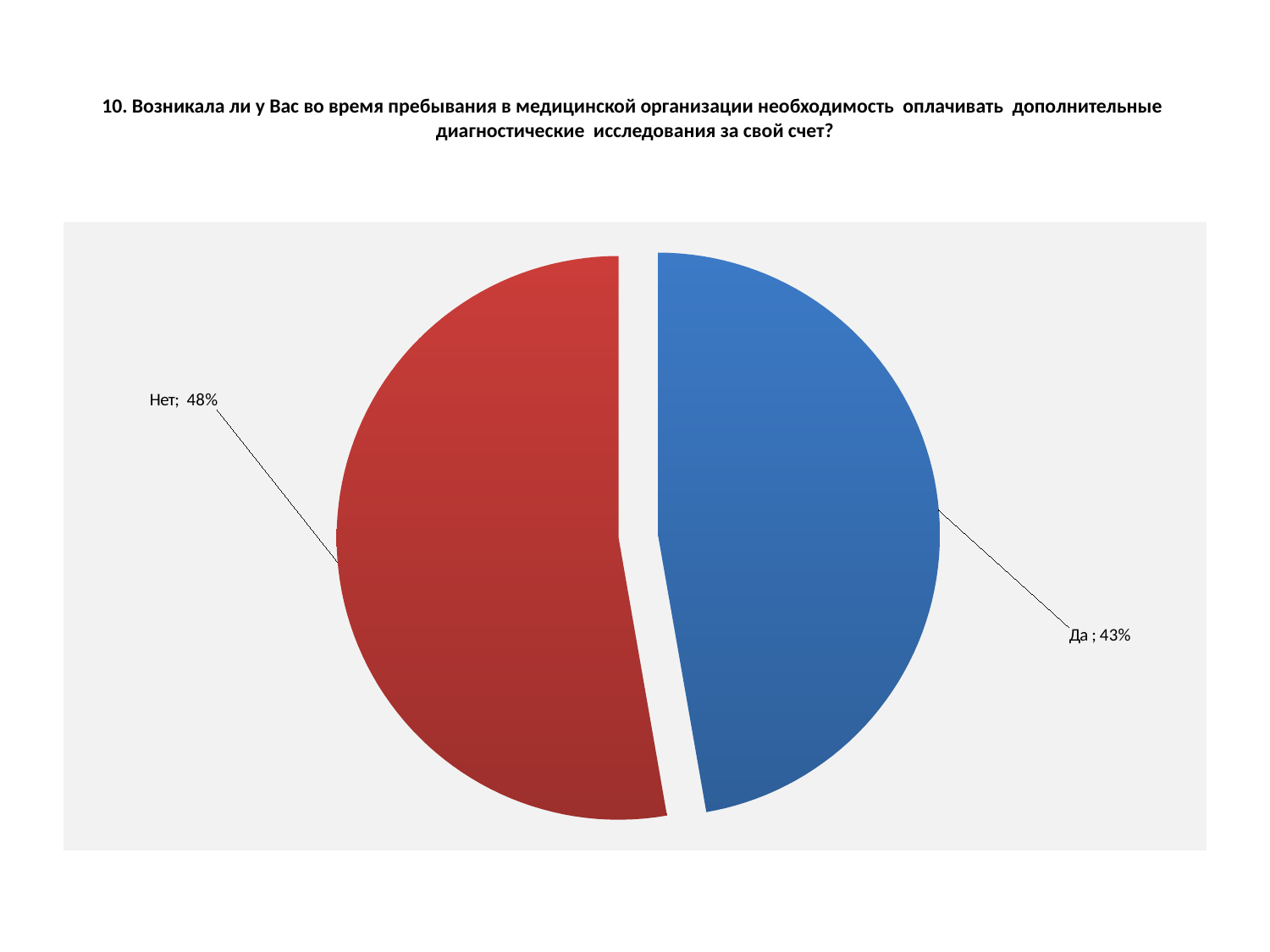
What percentage is shown for the "Да" slice? 43% Which is larger, the "Нет" slice or the "Да" slice? Нет Which slice of the pie is the largest? Нет What colour is the "Нет" slice? red What share of the pie does the "Да" slice represent? 43% What percentage is shown for the "Нет" slice? 48% How many slices does the pie chart have? 2 What type of chart is shown on the slide? pie chart What colour is the "Да" slice? blue Which slice of the pie is the smallest? Да By how many percentage points does the "Нет" slice exceed the "Да" slice? 5